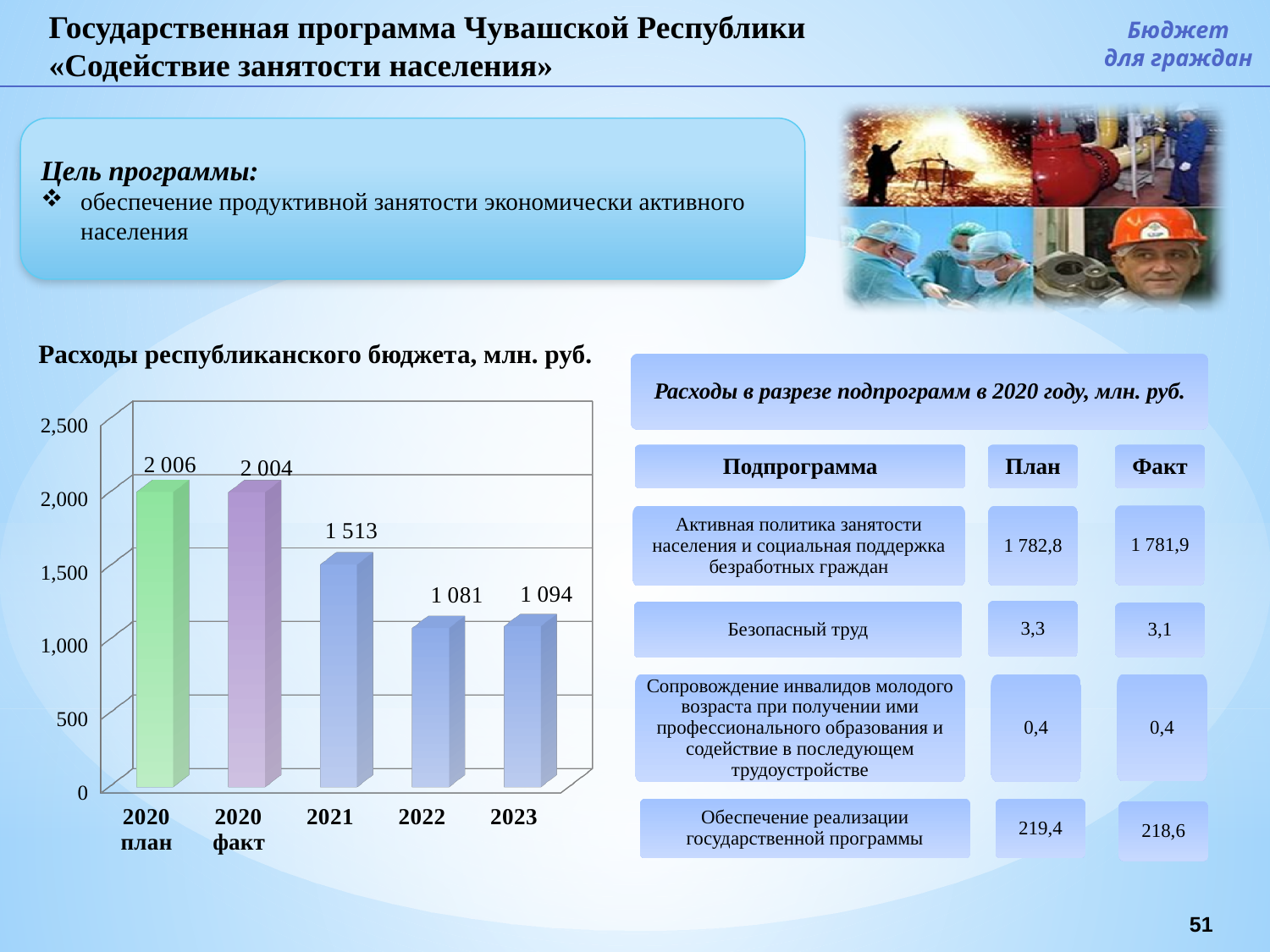
What is the value for 2023 in the bar chart? 1 094 What is the value for "2020 факт" in the bar chart? 2 004 What is the value for 2021 in the bar chart? 1 513 What is the difference between the values for 2021 and 2022 in the bar chart? 432 Which is larger in the bar chart, the value for 2022 or the value for 2023? 2023 What is the value for "2020 план" in the bar chart? 2 006 Which category has the highest value in the bar chart? 2020 план What is the difference between the values for "2020 факт" and 2021 in the bar chart? 491 Is the value for 2022 in the bar chart greater or less than 1,500? less Which category has the lowest value in the bar chart? 2022 What kind of chart is shown under the heading "Расходы республиканского бюджета, млн. руб."? bar chart How many bars are shown in the bar chart? 5